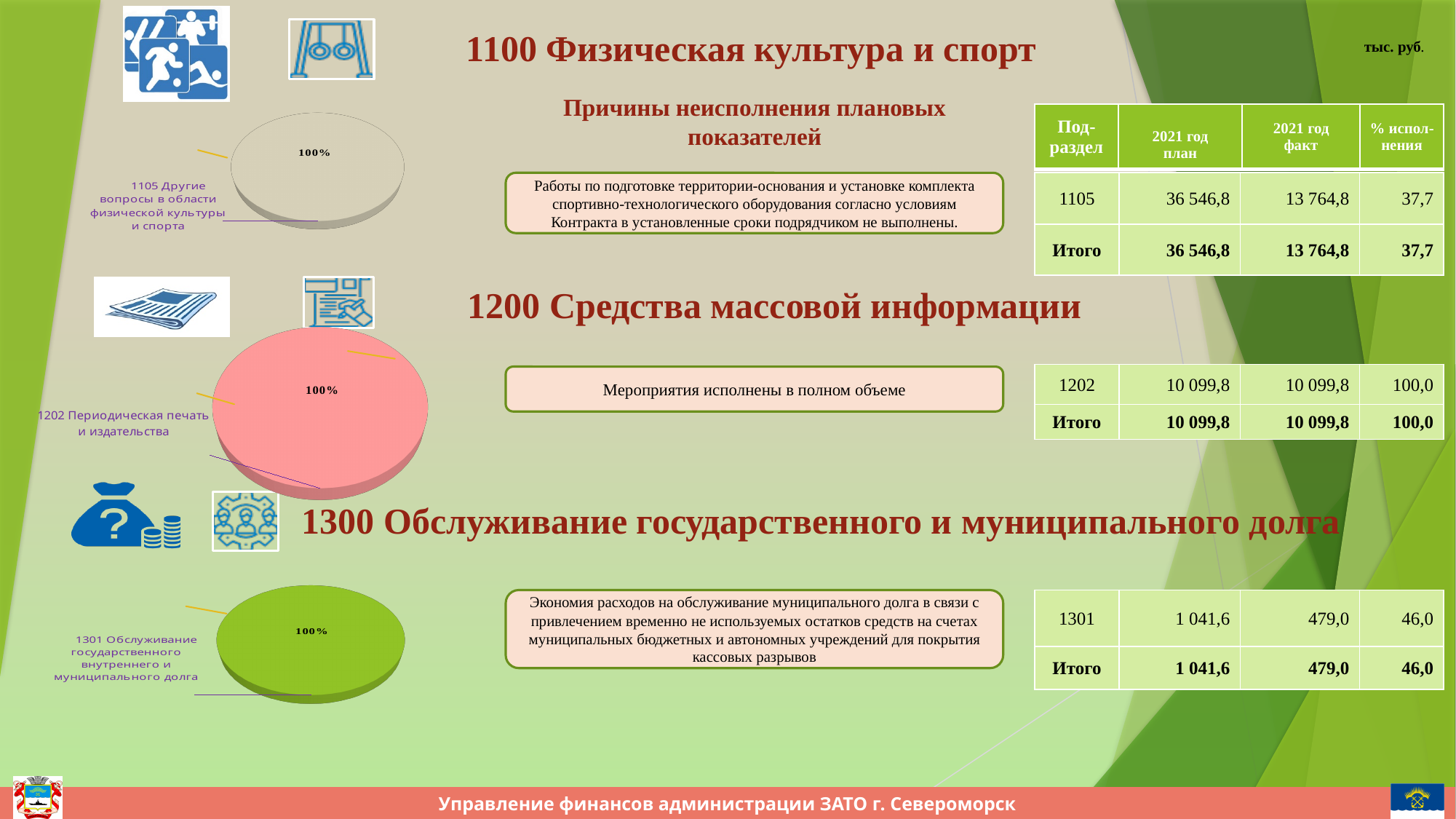
How many slices does the bottom pie chart (section 1300) contain? 1 What colour is the slice in the middle pie chart (section 1200)? pink How many categories are shown in the middle pie chart (section 1200)? 1 In the bottom pie chart, what share is labelled for '1301 Обслуживание государственного внутреннего и муниципального долга'? 100% What type of chart is shown next to the section '1100 Физическая культура и спорт'? pie chart What colour is the slice in the bottom pie chart (section 1300)? green In the top pie chart, what share is labelled for '1105 Другие вопросы в области физической культуры и спорта'? 100% How many slices does the top pie chart (section 1100) contain? 1 What type of chart is used for section '1300 Обслуживание государственного и муниципального долга'? pie chart In the middle pie chart, what share is labelled for '1202 Периодическая печать и издательства'? 100% What is the category label of the single slice in the top pie chart? 1105 Другие вопросы в области физической культуры и спорта